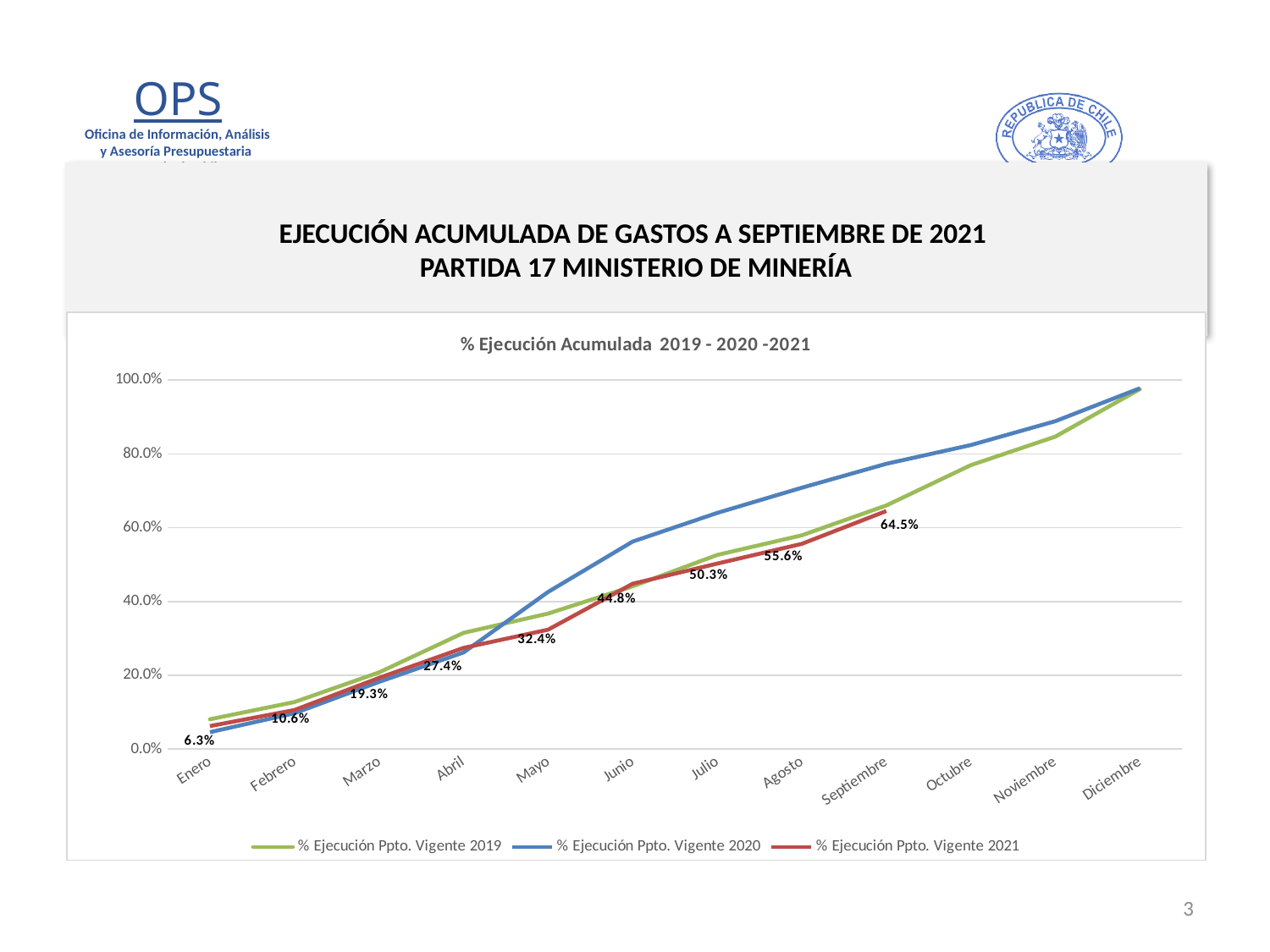
What type of chart is shown on the slide? Line chart What is the value for % Ejecución Ppto. Vigente 2021 in Septiembre? 64.5% How many series does the legend list? 3 Is the value for % Ejecución Ppto. Vigente 2020 in Junio greater or less than 40.0%? greater What is the value for % Ejecución Ppto. Vigente 2021 in Enero? 6.3% What is the value for % Ejecución Ppto. Vigente 2021 in Mayo? 32.4% What is the difference between the 2021 values for Septiembre and Agosto? 8.9% In Junio, which series has the larger value: % Ejecución Ppto. Vigente 2020 or % Ejecución Ppto. Vigente 2021? % Ejecución Ppto. Vigente 2020 What is the difference between the 2021 values for Junio and Mayo? 12.4% In which month does the % Ejecución Ppto. Vigente 2021 series reach its highest labelled value? Septiembre Do the values of the % Ejecución Ppto. Vigente 2021 series rise or fall from Enero to Septiembre? Rise How many months are shown along the x axis? 12